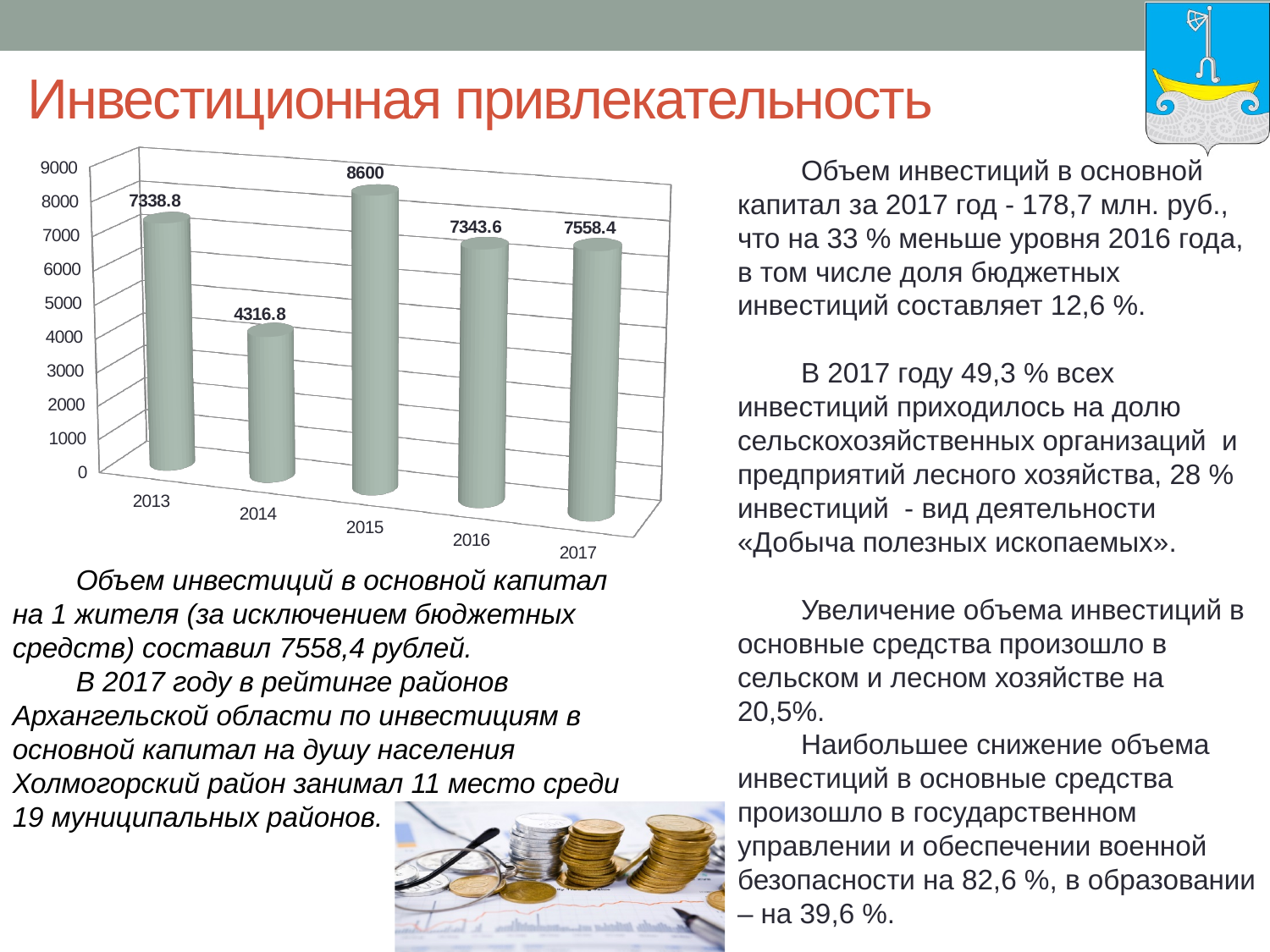
How many years are shown on the x axis? 5 What is the value shown for 2013? 7338.8 What is the value shown for 2014? 4316.8 What is the value shown for 2015? 8600 What is the difference between the values for 2017 and 2016? 214.8 What is the value shown for 2017? 7558.4 What kind of chart is shown on the slide? bar chart What is the difference between the values for 2015 and 2014? 4283.2 Which year has the highest value? 2015 Which is larger, the value for 2015 or the value for 2017? 2015 Which year has the lowest value? 2014 Is the value for 2014 greater or less than 5000? less